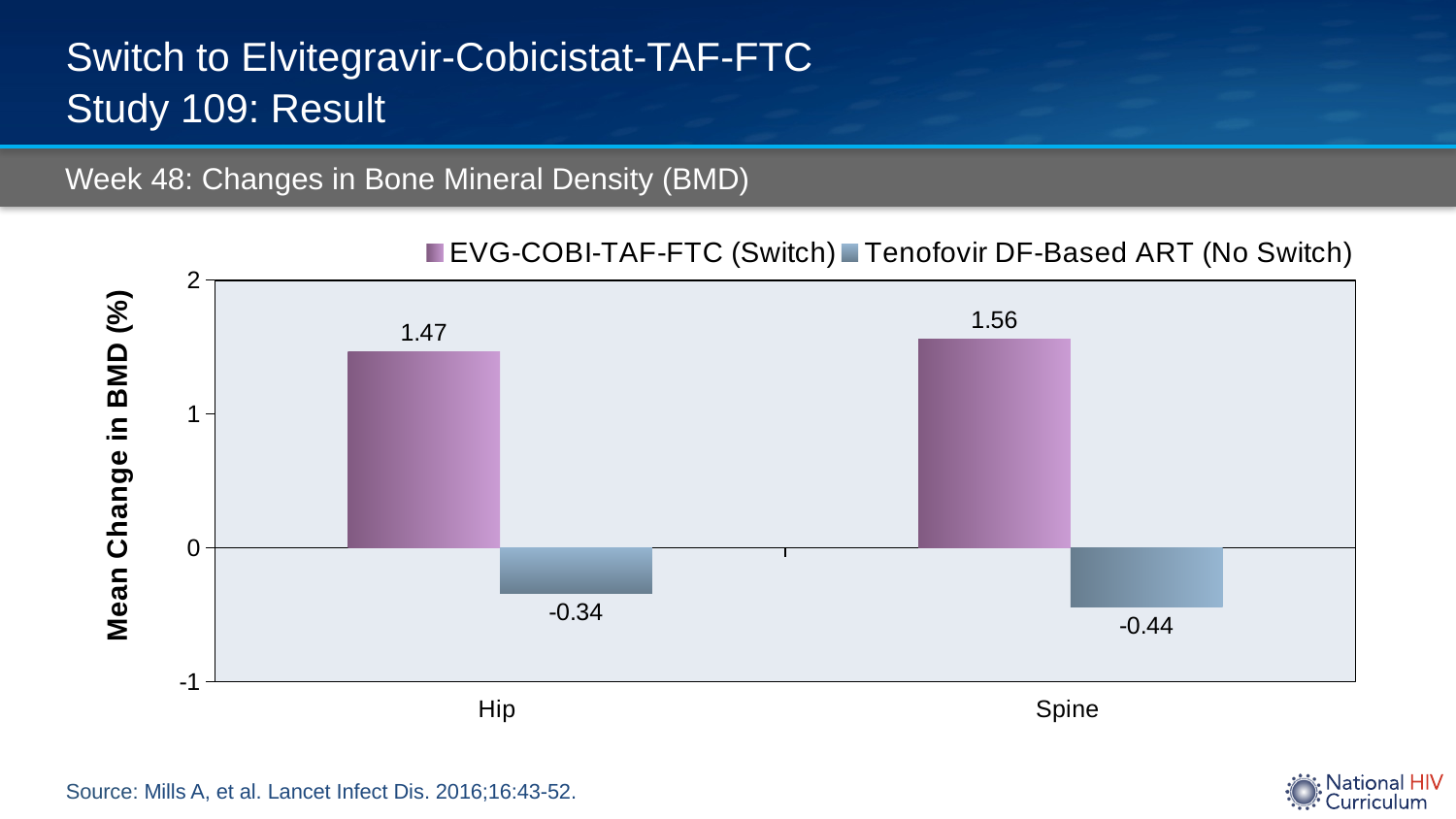
Which group has the larger mean change in BMD at the Spine, EVG-COBI-TAF-FTC (Switch) or Tenofovir DF-Based ART (No Switch)? EVG-COBI-TAF-FTC (Switch) What kind of chart is shown on the slide? Bar chart What is the mean change in BMD for the EVG-COBI-TAF-FTC (Switch) group at the Hip? 1.47 Which category has the highest value for the EVG-COBI-TAF-FTC (Switch) group? Spine What is the mean change in BMD for the Tenofovir DF-Based ART (No Switch) group at the Spine? -0.44 Which category has the lowest value for the Tenofovir DF-Based ART (No Switch) group? Spine What is the difference between the EVG-COBI-TAF-FTC (Switch) and Tenofovir DF-Based ART (No Switch) values at the Hip? 1.81 Is the value for EVG-COBI-TAF-FTC (Switch) at the Spine greater or less than 1? greater How many series does the legend list? 2 What is the difference between the EVG-COBI-TAF-FTC (Switch) values at the Spine and the Hip? 0.09 How many categories are shown on the x axis? 2 What is the mean change in BMD for the Tenofovir DF-Based ART (No Switch) group at the Hip? -0.34